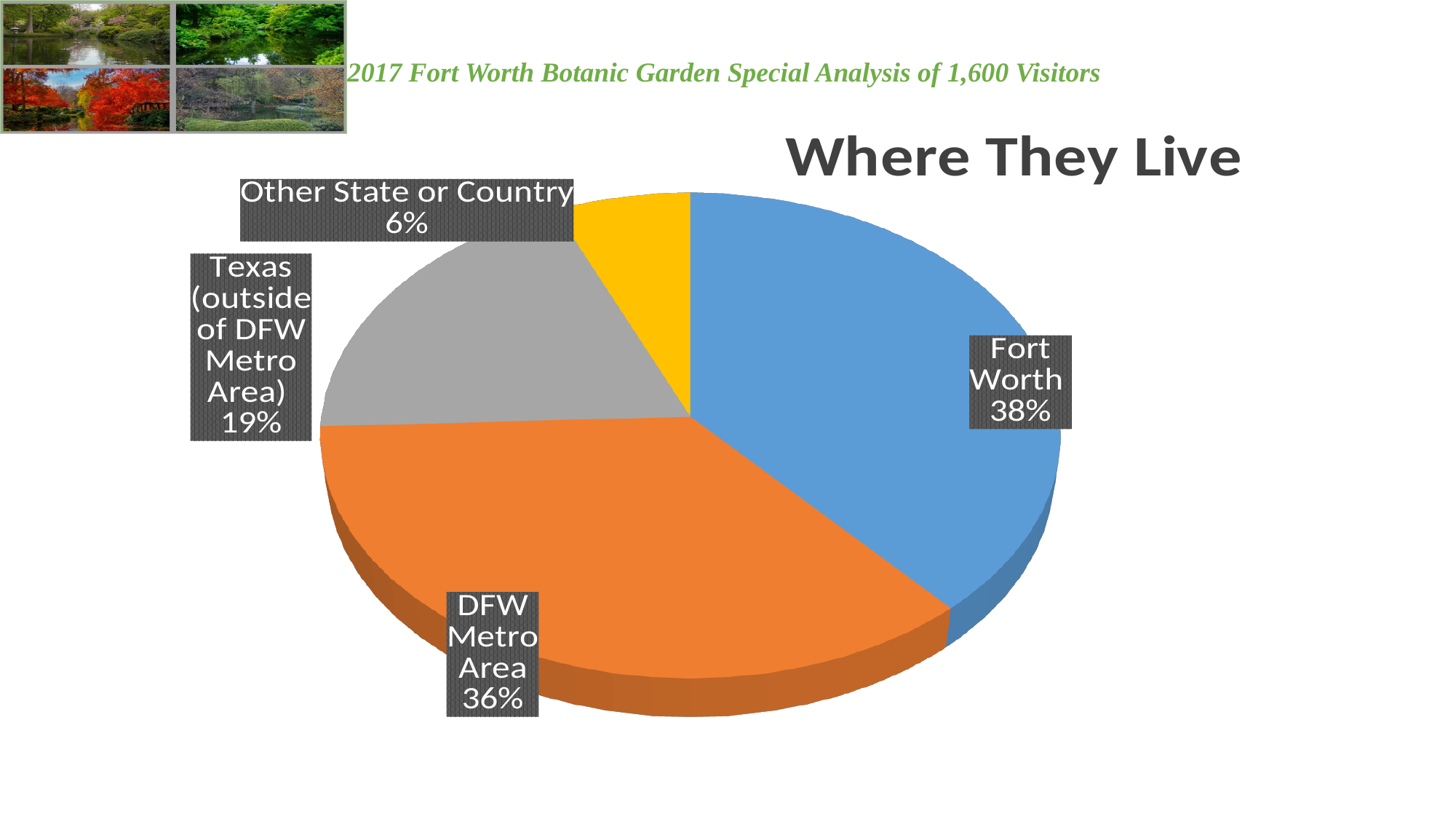
What is the difference in percentage points between Fort Worth and DFW Metro Area? 2 What share of visitors live in Texas (outside of DFW Metro Area)? 19% How many categories are shown in the pie chart? 4 Which category has the smallest share of the pie? Other State or Country What is the difference in percentage points between Texas (outside of DFW Metro Area) and Other State or Country? 13 Which category has the largest share of the pie? Fort Worth What kind of chart is shown on the slide? Pie chart What share of visitors live in the DFW Metro Area? 36% What share of visitors come from Other State or Country? 6% What is the title of the chart? Where They Live What share of visitors live in Fort Worth? 38% Which is larger: the share for Texas (outside of DFW Metro Area) or the share for Other State or Country? Texas (outside of DFW Metro Area)